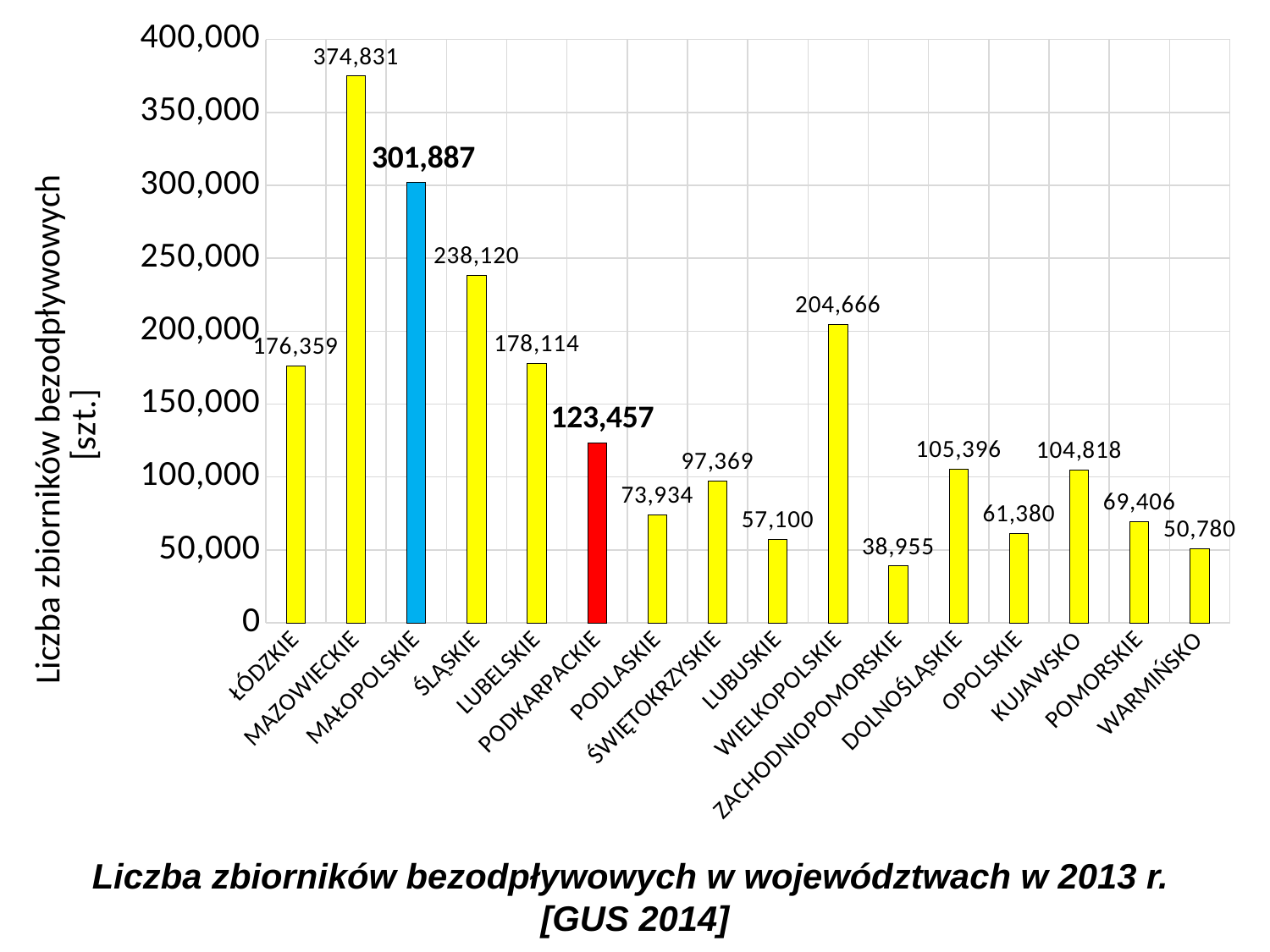
What is the value for MAZOWIECKIE? 374,831 Which voivodeship has the highest number of cesspools? MAZOWIECKIE What kind of chart is shown on the slide? bar chart Which is larger, the value for WIELKOPOLSKIE or the value for LUBELSKIE? WIELKOPOLSKIE How many voivodeships are shown on the x axis? 16 Which bar is coloured red? PODKARPACKIE What is the value for PODKARPACKIE? 123,457 Which voivodeship has the lowest number of cesspools? ZACHODNIOPOMORSKIE Is the value for WIELKOPOLSKIE greater or less than 200,000? greater What is the difference between the values for MAZOWIECKIE and MAŁOPOLSKIE? 72,944 What is the difference between the values for ŚLĄSKIE and LUBELSKIE? 60,006 What is the value for ZACHODNIOPOMORSKIE? 38,955